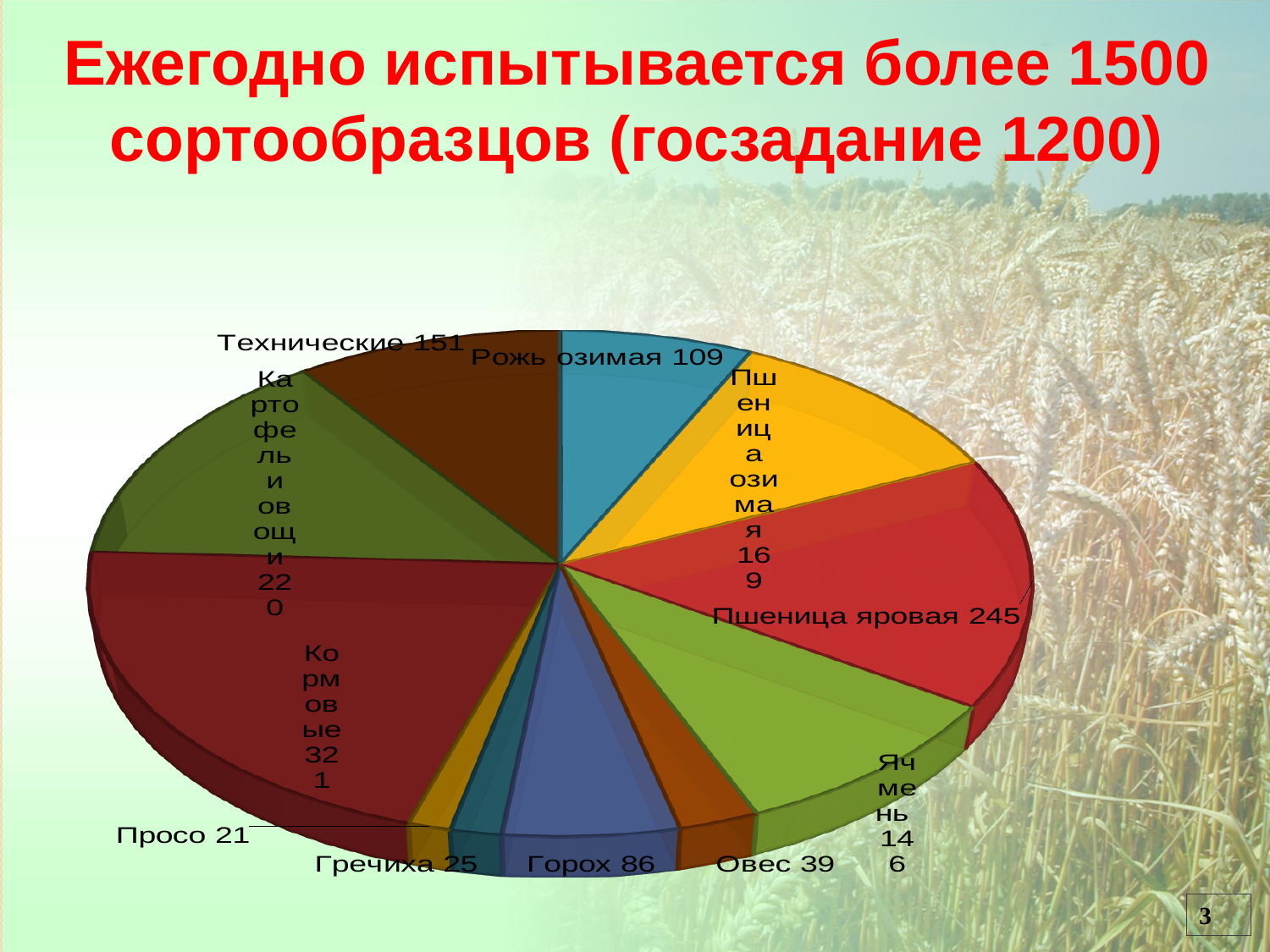
What is the value for Пшеница яровая? 245 What is the value for Горох? 86 Which category has the largest value? Кормовые Which category has the smallest value? Просо What is the value for Технические? 151 What is the value for Картофель и овощи? 220 What is the difference between the values for Пшеница яровая and Пшеница озимая? 76 How many categories (slices) does the pie chart have? 11 What is the value for Рожь озимая? 109 What kind of chart is shown on the slide? pie chart Which is larger, the value for Ячмень or the value for Рожь озимая? Ячмень What is the difference between the values for Горох and Овес? 47